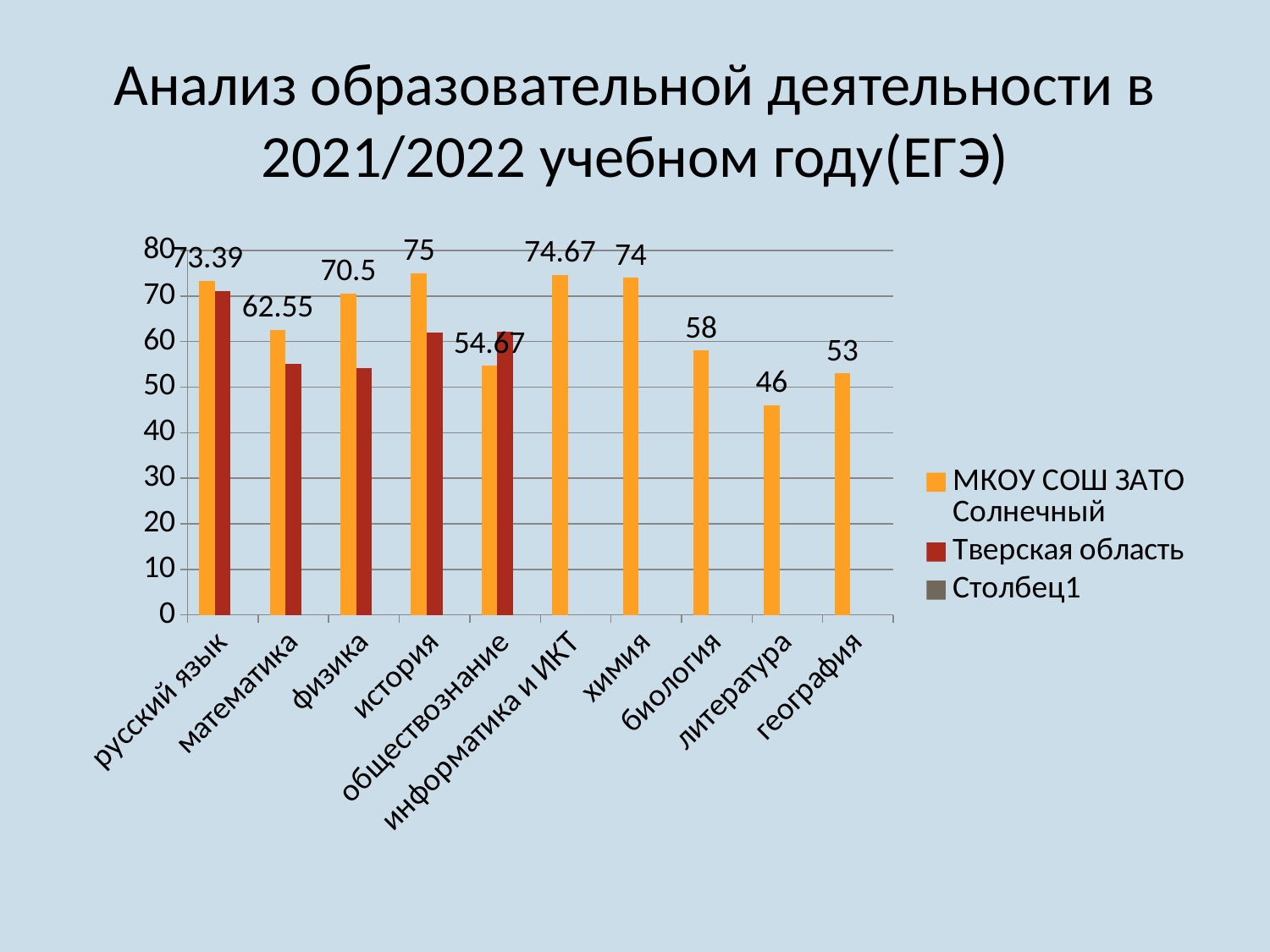
What kind of chart is shown on the slide? bar chart What is the value for МКОУ СОШ ЗАТО Солнечный in математика? 62.55 Which subject has the lowest value for МКОУ СОШ ЗАТО Солнечный? литература What is the value for МКОУ СОШ ЗАТО Солнечный in информатика и ИКТ? 74.67 What is the value for МКОУ СОШ ЗАТО Солнечный in литература? 46 What is the value for МКОУ СОШ ЗАТО Солнечный in русский язык? 73.39 Which subject has the highest value for МКОУ СОШ ЗАТО Солнечный? история How many subjects are shown on the x axis? 10 Is the Тверская область value for история greater or less than 50? greater How many series does the legend list? 3 What is the difference between the МКОУ СОШ ЗАТО Солнечный values for биология and география? 5 Which is larger for МКОУ СОШ ЗАТО Солнечный: физика or обществознание? физика